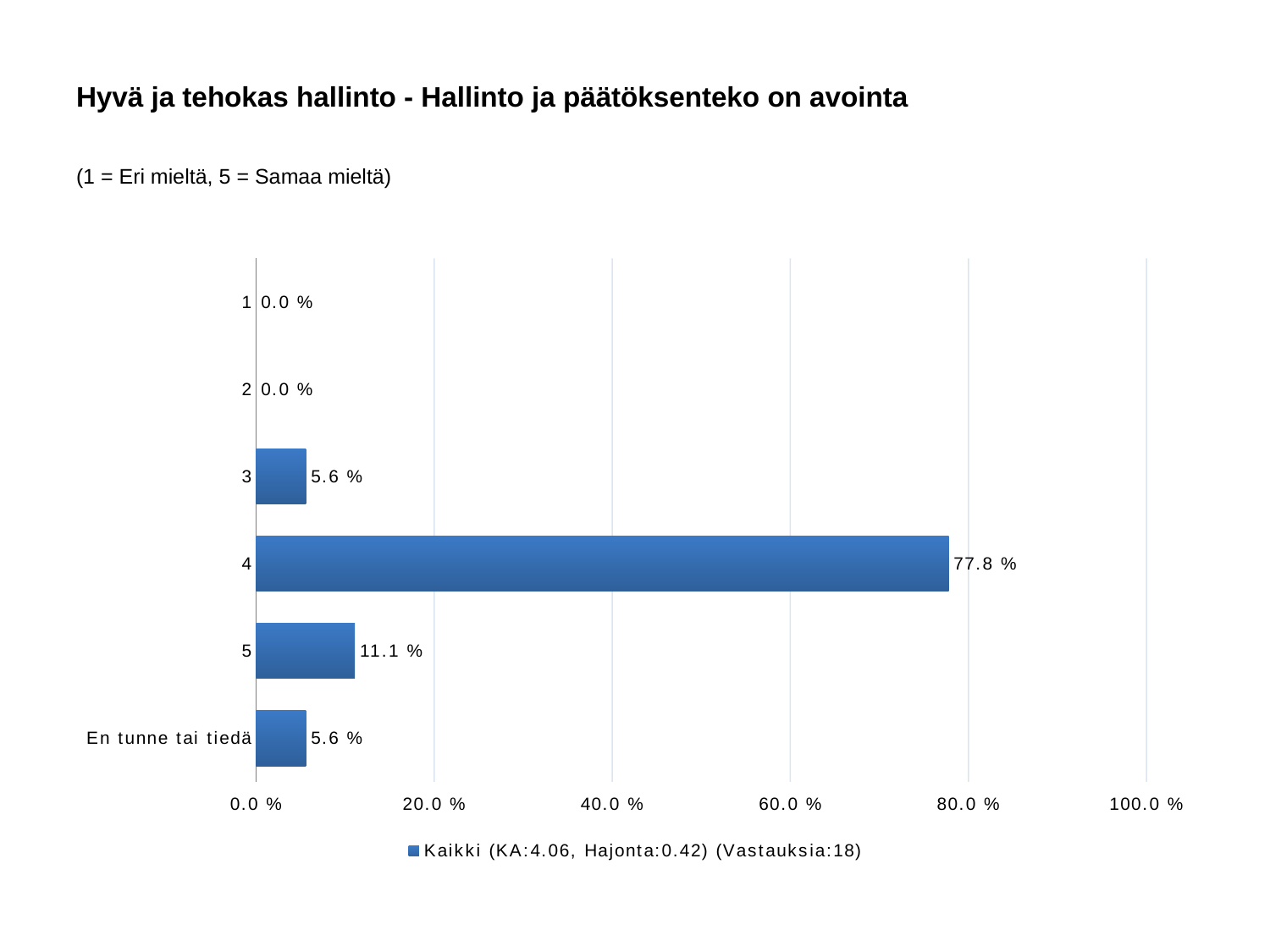
What is the value for category 5? 11.1 % What is the value for category 4? 77.8 % Is the value for category 4 greater or less than 60.0 %? greater Which is larger, the value for category 3 or the value for category 5? 5 What is the difference between the values for category 4 and category 5? 66.7 % How many series does the legend list? 1 What kind of chart is shown on the slide? bar chart What is the value for category 1? 0.0 % How many categories are shown on the chart? 6 What is the number of responses (Vastauksia) given in the legend? 18 Which category has the highest value? 4 What is the value for 'En tunne tai tiedä'? 5.6 %